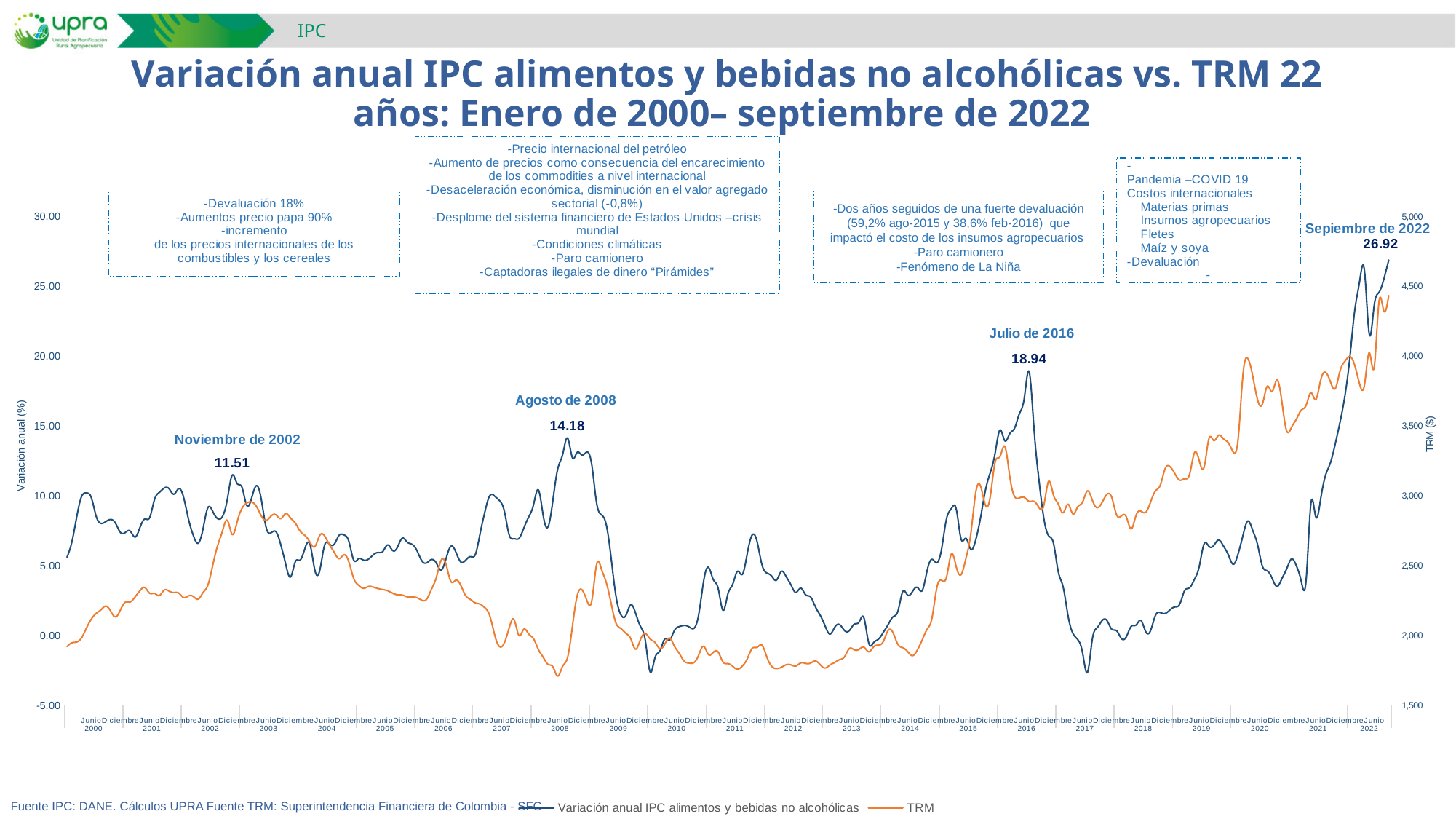
Which of the four labeled peaks has the highest value? Septiembre de 2022 What value is labeled for Noviembre de 2002 on the IPC line? 11.51 Which of the four labeled peaks has the lowest value? Noviembre de 2002 Is the TRM value at the end of the series in 2022 greater or less than 4,000? greater How many series does the legend list? 2 What value is labeled for Agosto de 2008 on the IPC line? 14.18 What is the difference between the labeled values for Septiembre de 2022 and Julio de 2016? 7.98 What value is labeled for Julio de 2016 on the IPC line? 18.94 What is the label of the right-hand vertical axis? TRM ($) What kind of chart is shown on the slide? line chart Which labeled peak is larger: Agosto de 2008 or Julio de 2016? Julio de 2016 What value is labeled for Septiembre de 2022 on the IPC line? 26.92